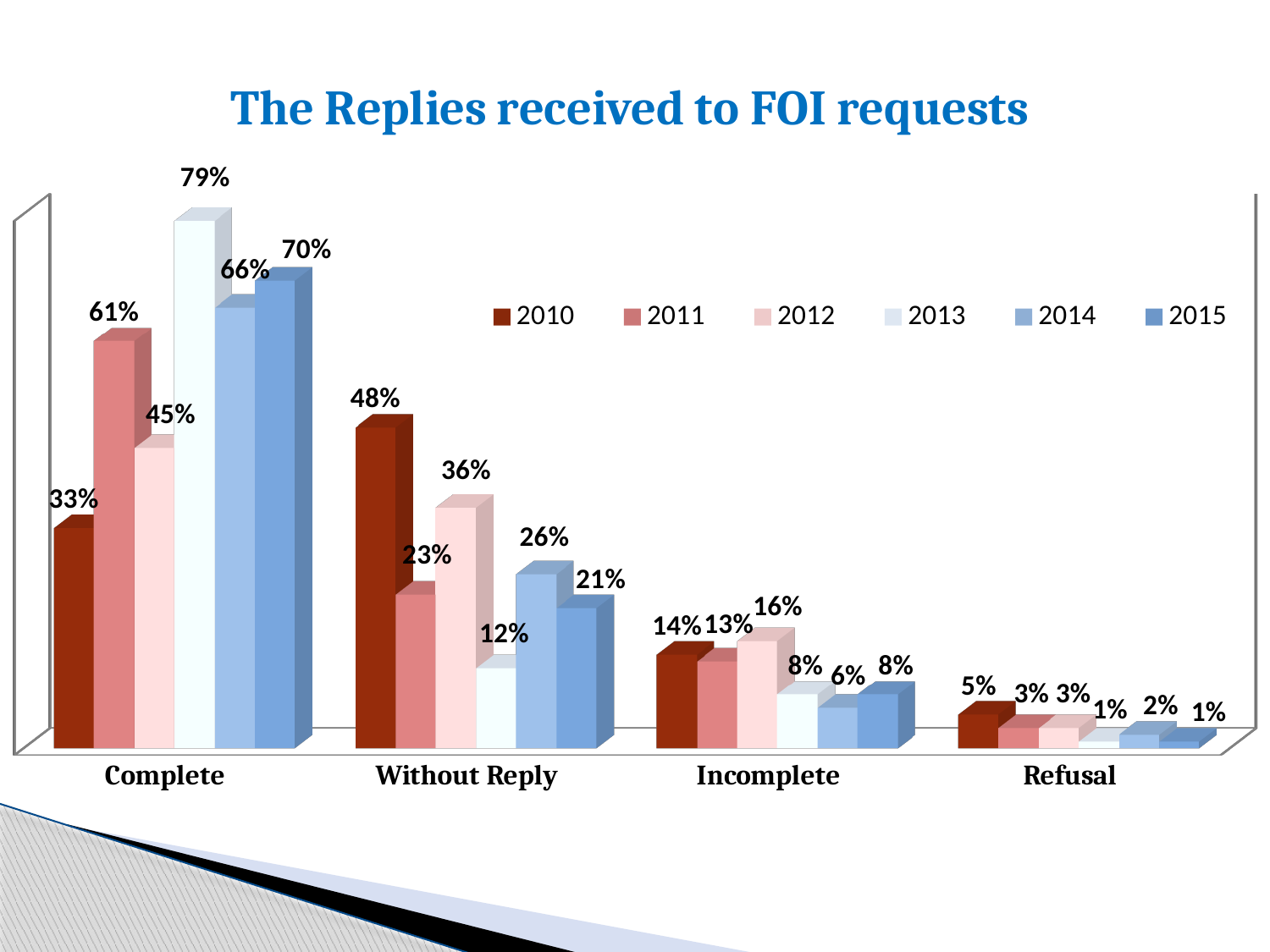
Which year has the highest value in the Complete category? 2013 Which is larger in the Without Reply category: the value for 2012 or the value for 2014? 2012 What is the value for 2014 in the Incomplete category? 6% How many categories are shown on the x axis? 4 How many series does the legend list? 6 What is the difference between the 2010 and 2013 values in the Refusal category? 4% Which year has the lowest value in the Without Reply category? 2013 What is the value for 2010 in the Without Reply category? 48% What type of chart is shown on the slide? Bar chart What is the difference between the 2015 and 2010 values in the Complete category? 37% What is the value for 2013 in the Complete category? 79% What is the title of the chart? The Replies received to FOI requests